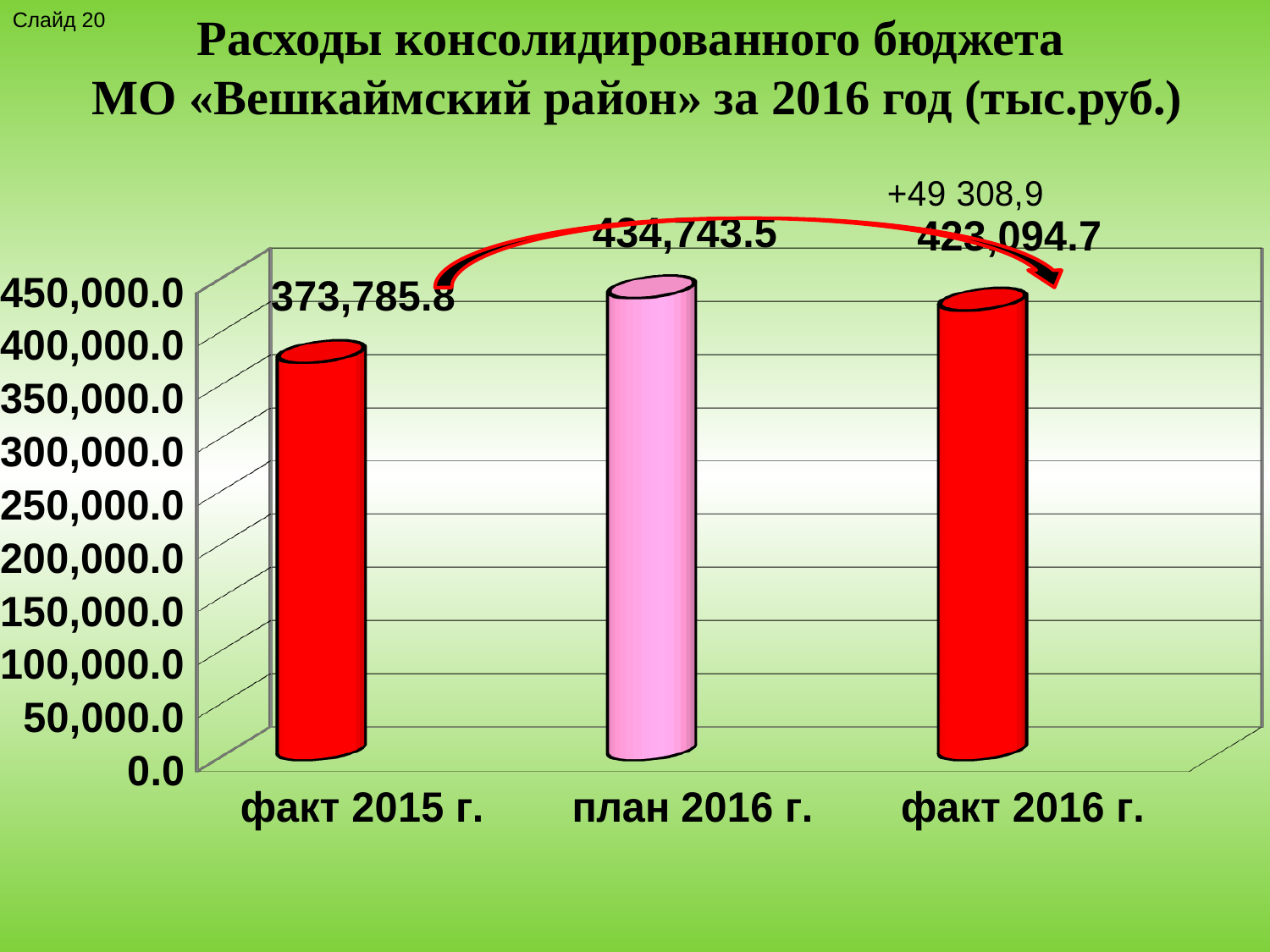
What kind of chart is shown on the slide? bar chart Which category has the lowest value? факт 2015 г. What is the difference between the values for факт 2016 г. and факт 2015 г.? 49,308.9 Which category has the highest value? план 2016 г. Is the value for факт 2015 г. greater or less than 400,000.0? less Which is larger, the value for план 2016 г. or the value for факт 2016 г.? план 2016 г. What is the value for факт 2016 г.? 423,094.7 What is the value for план 2016 г.? 434,743.5 What is the value for факт 2015 г.? 373,785.8 What is the title of the chart? Расходы консолидированного бюджета МО «Вешкаймский район» за 2016 год (тыс.руб.) How many categories are shown on the chart? 3 What is the difference between the values for план 2016 г. and факт 2016 г.? 11,648.8